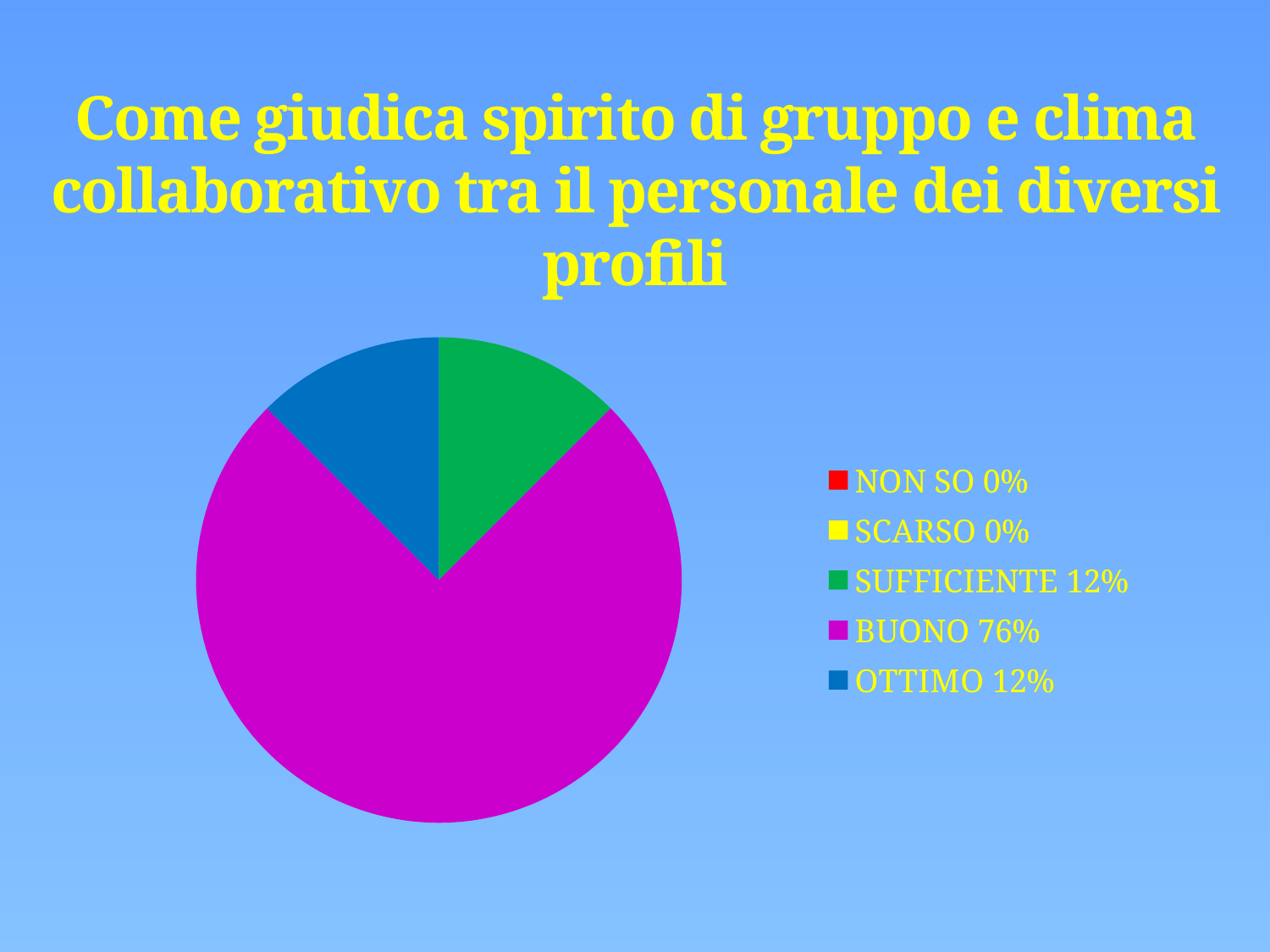
What percentage is shown for SUFFICIENTE? 12% What percentage is shown for NON SO? 0% What is the title of the chart? Come giudica spirito di gruppo e clima collaborativo tra il personale dei diversi profili Which category has the largest share of the pie? BUONO Which is larger, the share for BUONO or the share for SUFFICIENTE? BUONO What percentage is shown for OTTIMO? 12% What percentage is shown for BUONO? 76% What kind of chart is shown on the slide? pie chart How many categories does the legend list? 5 What colour is the BUONO slice? magenta What percentage is shown for SCARSO? 0% What is the difference between the BUONO share and the OTTIMO share? 64%